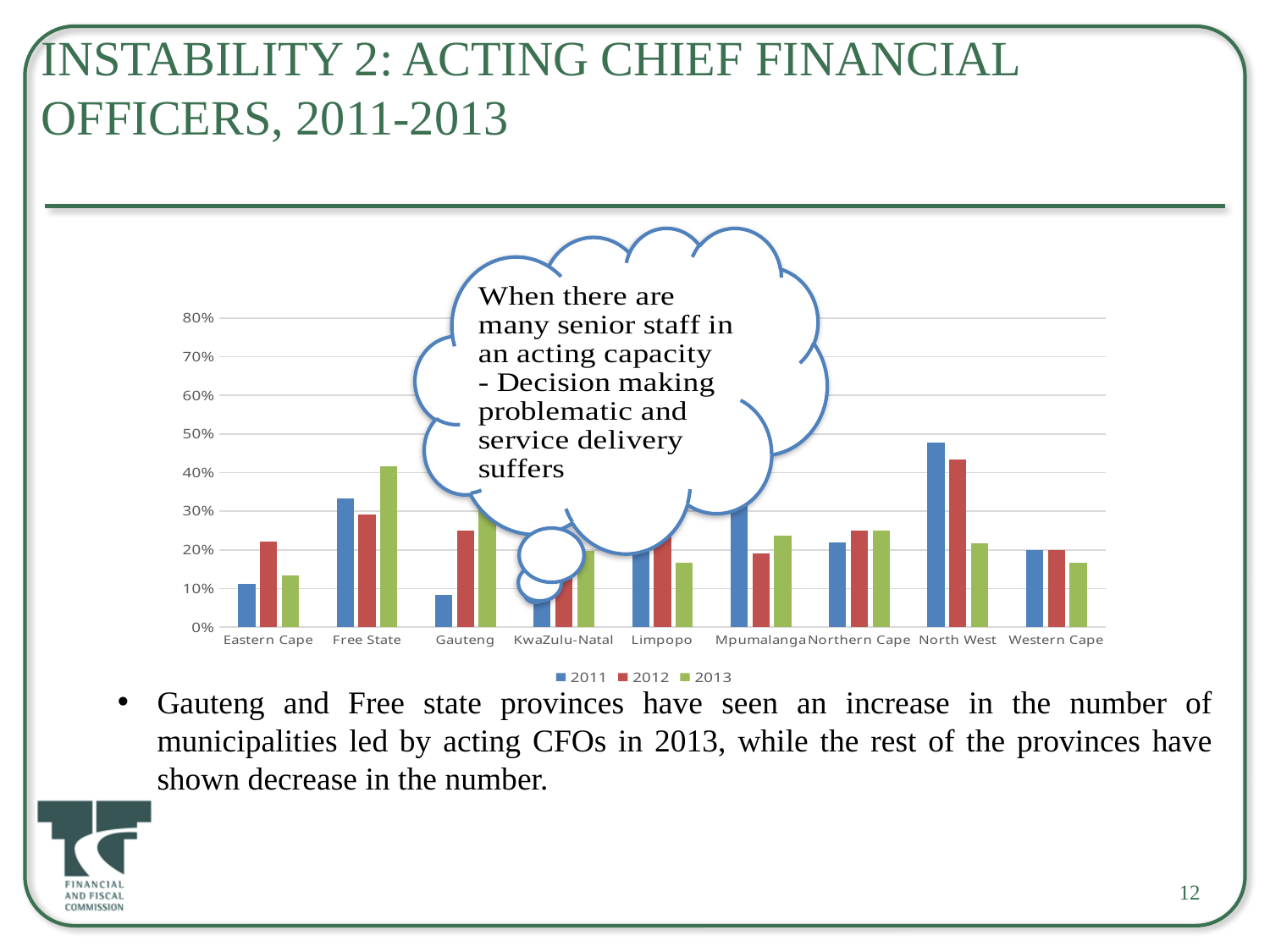
Which province has the highest value for 2012? North West Is the 2011 value for North West greater or less than 40%? greater Is the 2013 value for Free State greater or less than 30%? greater For Eastern Cape, which is larger: the 2011 value or the 2012 value? 2012 Is the 2011 value for Eastern Cape greater or less than 20%? less How many provinces are shown on the x axis of the chart? 9 What kind of chart is shown on the slide? bar chart How many series does the chart legend list? 3 Which years are listed in the chart legend? 2011, 2012 and 2013 Do the values for North West rise or fall from 2011 to 2013? fall